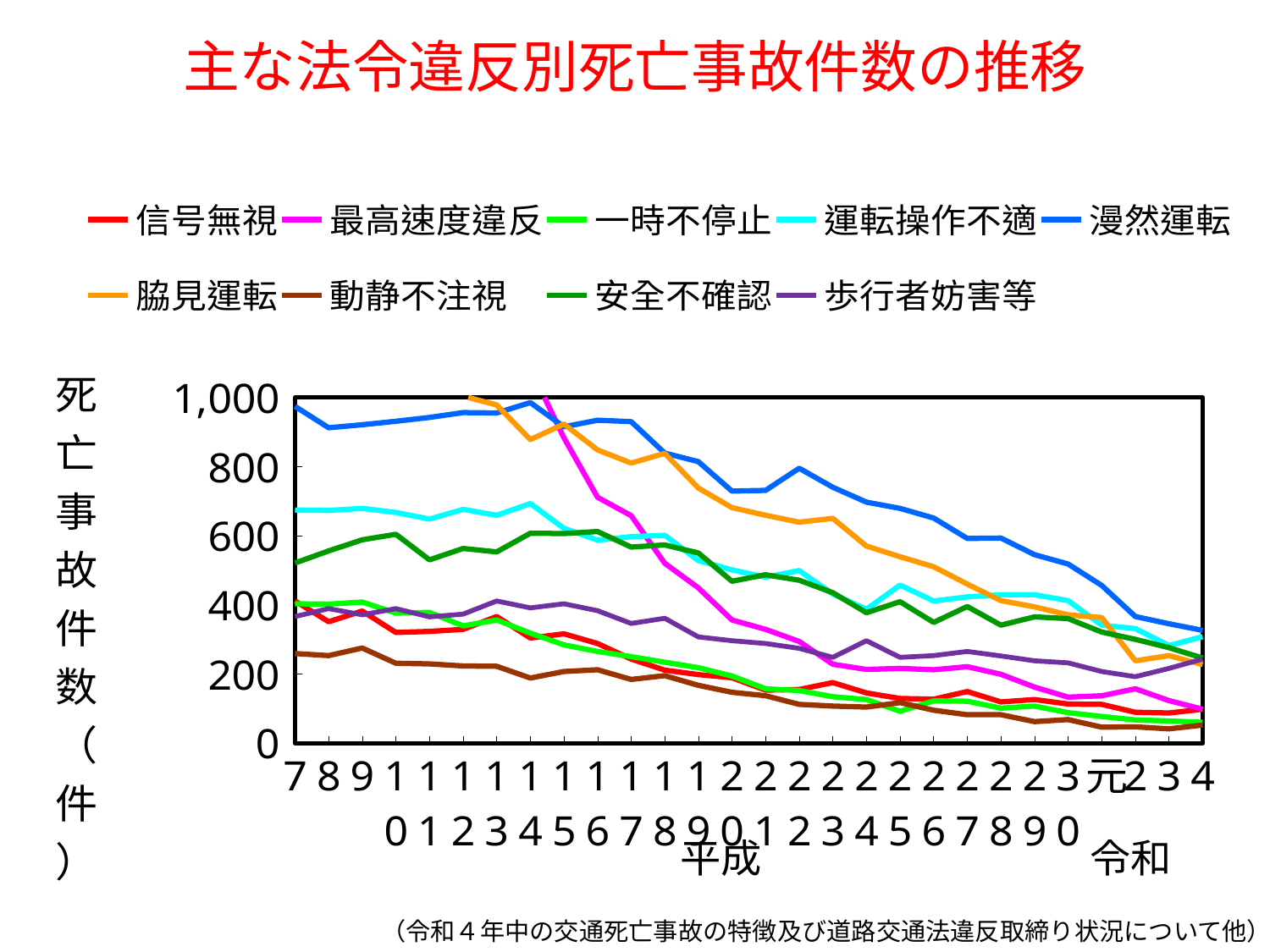
What kind of chart is shown on the slide? line chart What colour is the line for 信号無視 in the legend? red Which series has the lowest value in 平成7? 動静不注視 In 令和4, which is larger, 漫然運転 or 最高速度違反? 漫然運転 Is the value for 運転操作不適 in 平成7 greater or less than 600? greater Is the value for 最高速度違反 in 令和4 greater or less than 200? less Does the value for 漫然運転 rise or fall from 平成7 to 令和4? fall What is the title of the chart? 主な法令違反別死亡事故件数の推移 Is the value for 漫然運転 in 平成7 greater or less than 800? greater Does the value for 最高速度違反 rise or fall from 平成15 to 令和4? fall How many series does the legend list? 9